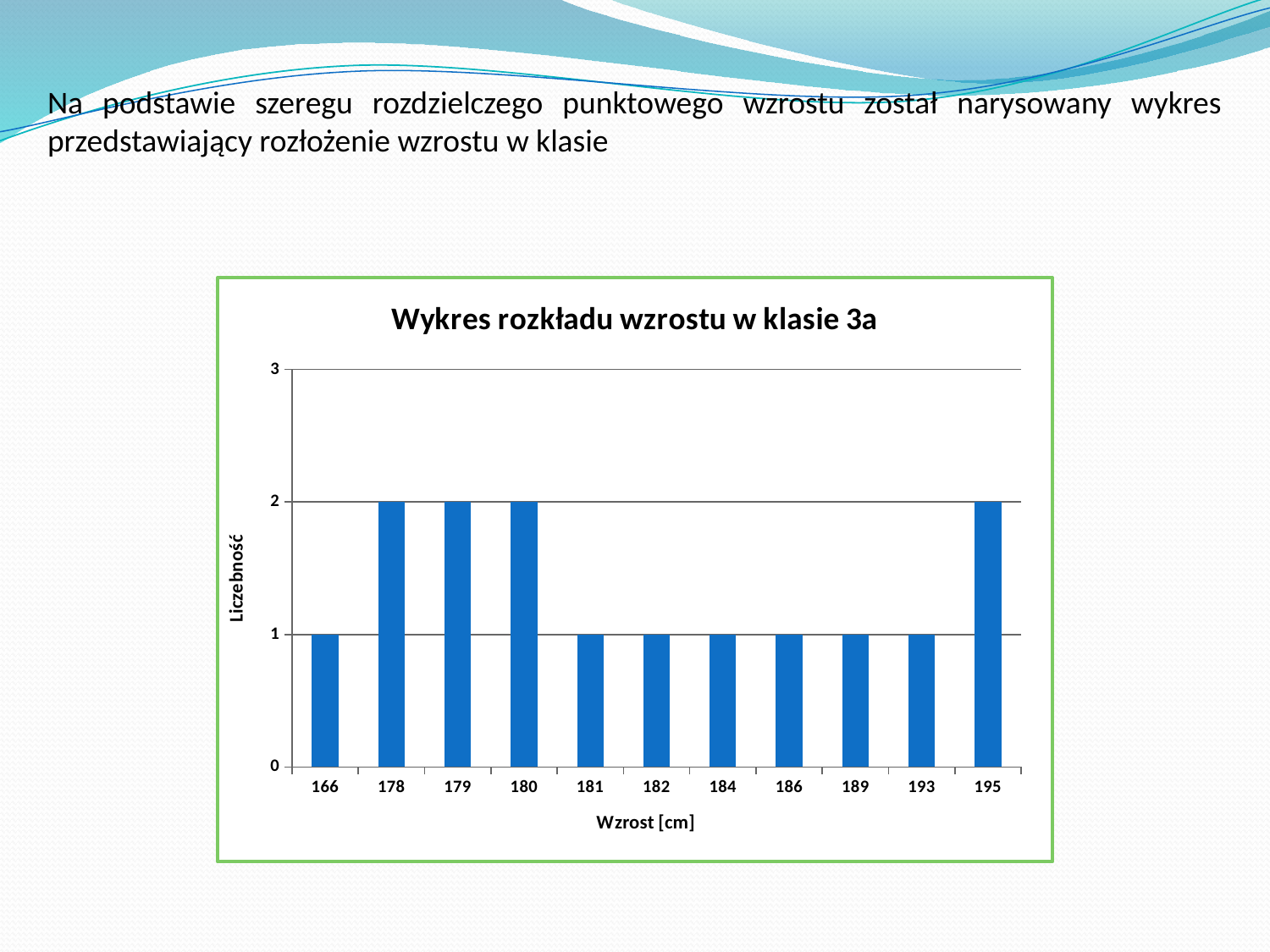
What is the value (Liczebność) for the height 195 cm? 2 What type of chart is shown on the slide? bar chart What is the value (Liczebność) for the height 166 cm? 1 What is the title of the chart? Wykres rozkładu wzrostu w klasie 3a What is the total of all the bar values in the chart? 15 What is the value (Liczebność) for the height 178 cm? 2 What is the difference between the values for 179 cm and 182 cm? 1 Which has a larger value, 180 cm or 181 cm? 180 cm What is the label of the x axis of the chart? Wzrost [cm] What is the value (Liczebność) for the height 186 cm? 1 How many height categories are shown on the x axis of the chart? 11 How many height categories have a value of 2? 4